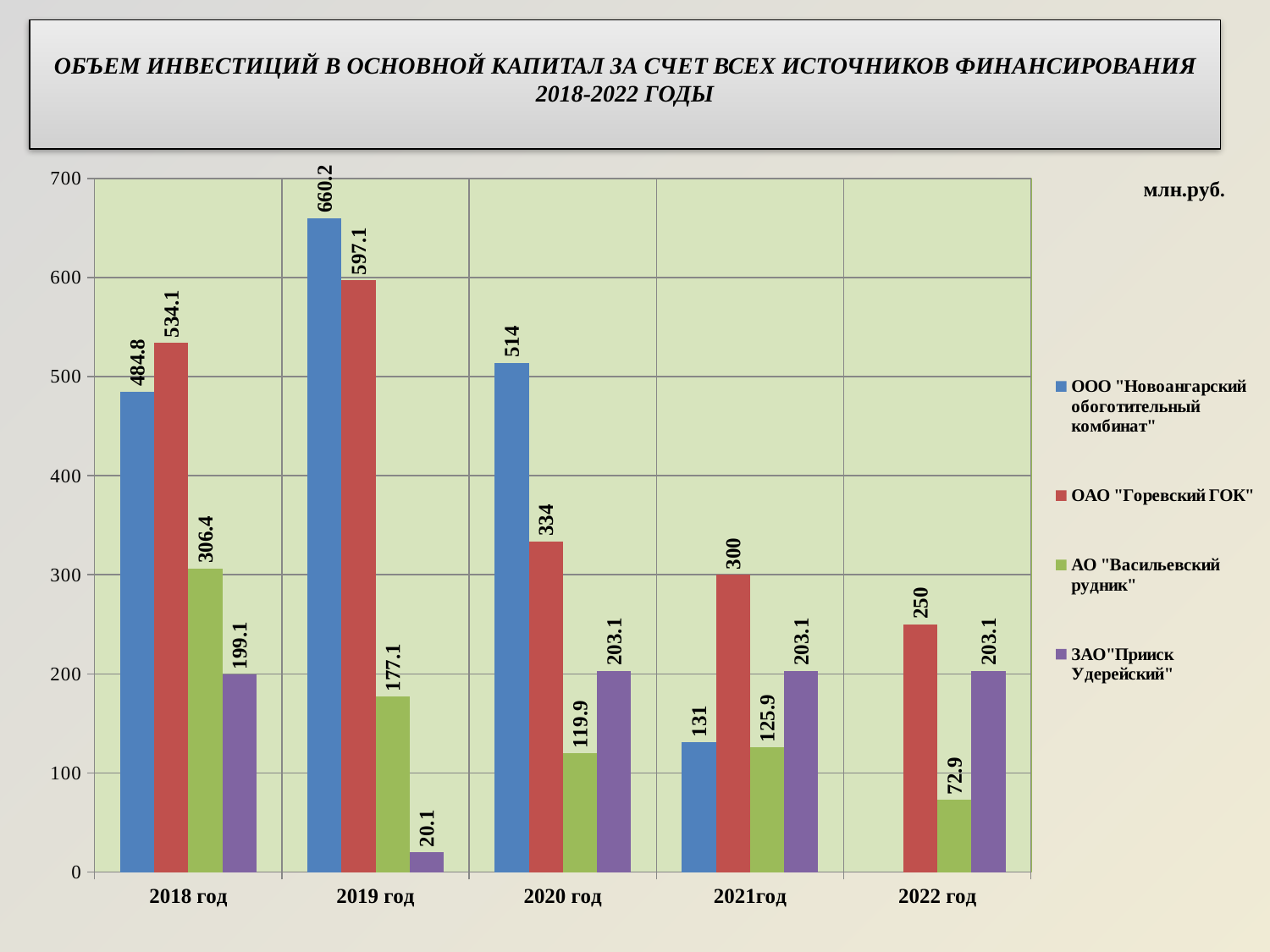
What type of chart is shown on the slide? bar chart Which is larger in 2018 год: ООО "Новоангарский обогатительный комбинат" or ОАО "Горевский ГОК"? ОАО "Горевский ГОК" What is the value for ЗАО "Прииск Удерейский" in 2019 год? 20.1 What is the difference between the values for ООО "Новоангарский обогатительный комбинат" and ОАО "Горевский ГОК" in 2020 год? 180 In which year is the value for АО "Васильевский рудник" lowest? 2022 год What unit is indicated next to the chart? млн.руб. In which year is the value for ОАО "Горевский ГОК" highest? 2019 год What is the value for АО "Васильевский рудник" in 2022 год? 72.9 How many series does the legend list? 4 Does the value for ОАО "Горевский ГОК" rise or fall from 2019 год to 2022 год? fall What is the value for ООО "Новоангарский обогатительный комбинат" in 2019 год? 660.2 How many year categories are shown on the x axis? 5